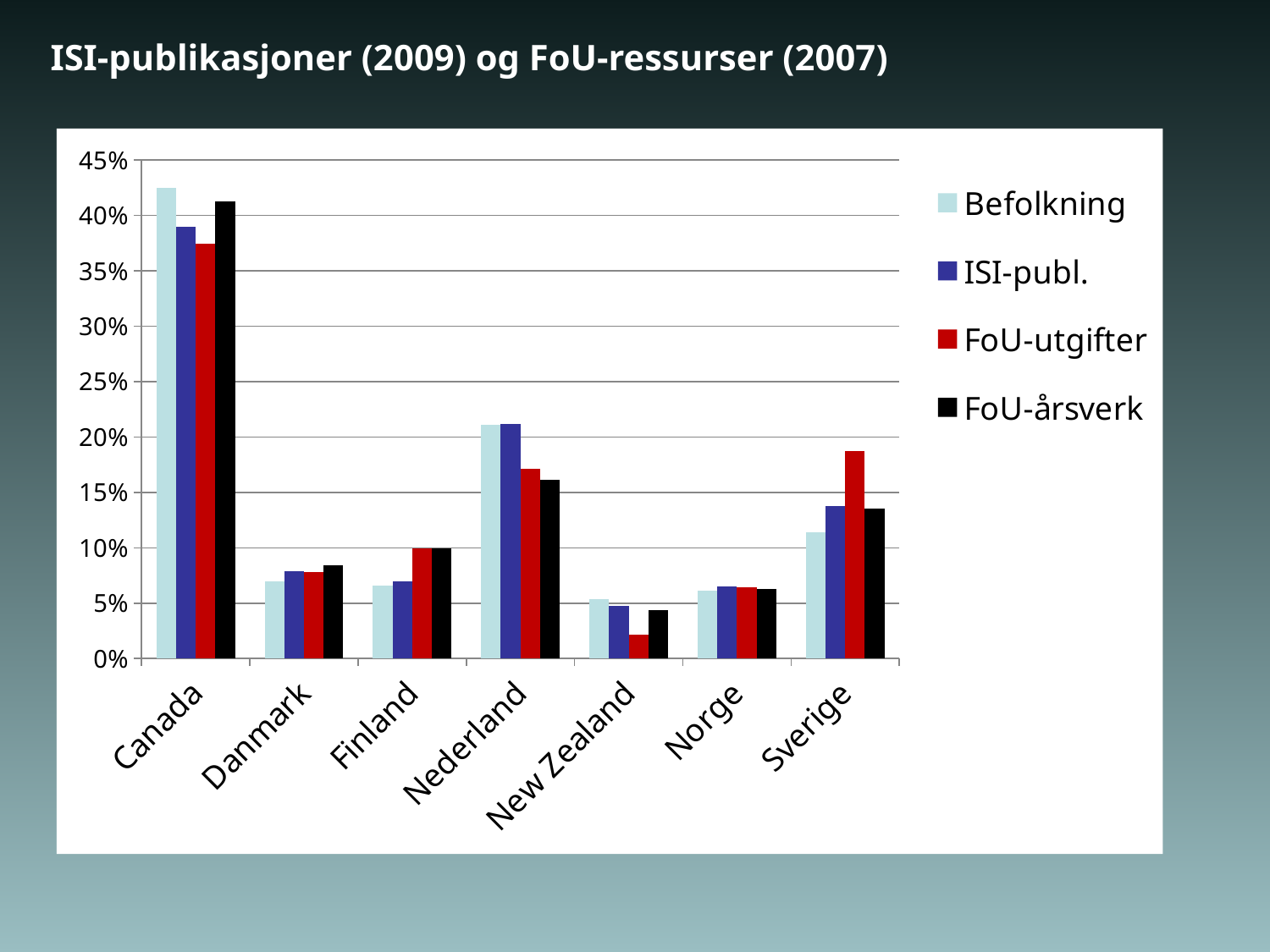
How many series does the legend list? 4 Is the FoU-utgifter value for Nederland greater or less than 15%? greater Which country has the highest Befolkning value? Canada Is the FoU-utgifter value for New Zealand greater or less than 5%? less What kind of chart is shown on the slide? bar chart Which has the larger Befolkning value: Nederland or Sverige? Nederland Is the FoU-utgifter value for Sverige greater or less than 15%? greater What colour represents the FoU-utgifter series in the legend? red How many countries are shown on the x axis of the chart? 7 For Sverige, which is larger: FoU-utgifter or Befolkning? FoU-utgifter Which country has the lowest FoU-utgifter value? New Zealand